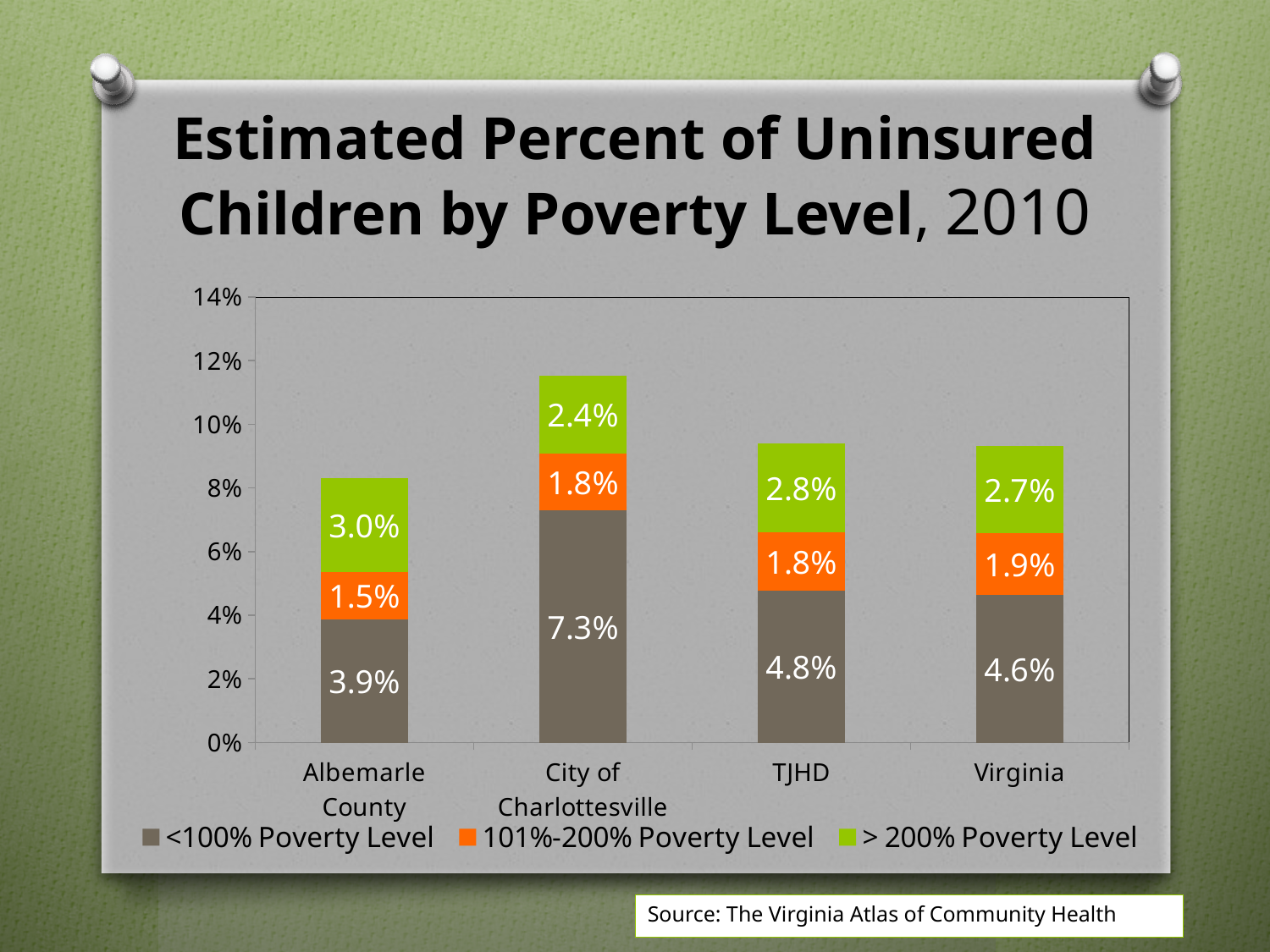
What is the total of the stacked bar for Albemarle County? 8.4% Which category has the highest value for <100% Poverty Level? City of Charlottesville What is the value for > 200% Poverty Level in Albemarle County? 3.0% How many categories are shown on the x axis? 4 How many series does the legend list? 3 What kind of chart is shown on the slide? Stacked bar chart What is the value for <100% Poverty Level in the City of Charlottesville? 7.3% What is the difference between the <100% Poverty Level values for City of Charlottesville and TJHD? 2.5% What is the total of the stacked bar for City of Charlottesville? 11.5% Which is larger: the > 200% Poverty Level value for TJHD or for City of Charlottesville? TJHD Which category has the lowest value for 101%-200% Poverty Level? Albemarle County What is the value for 101%-200% Poverty Level in Virginia? 1.9%